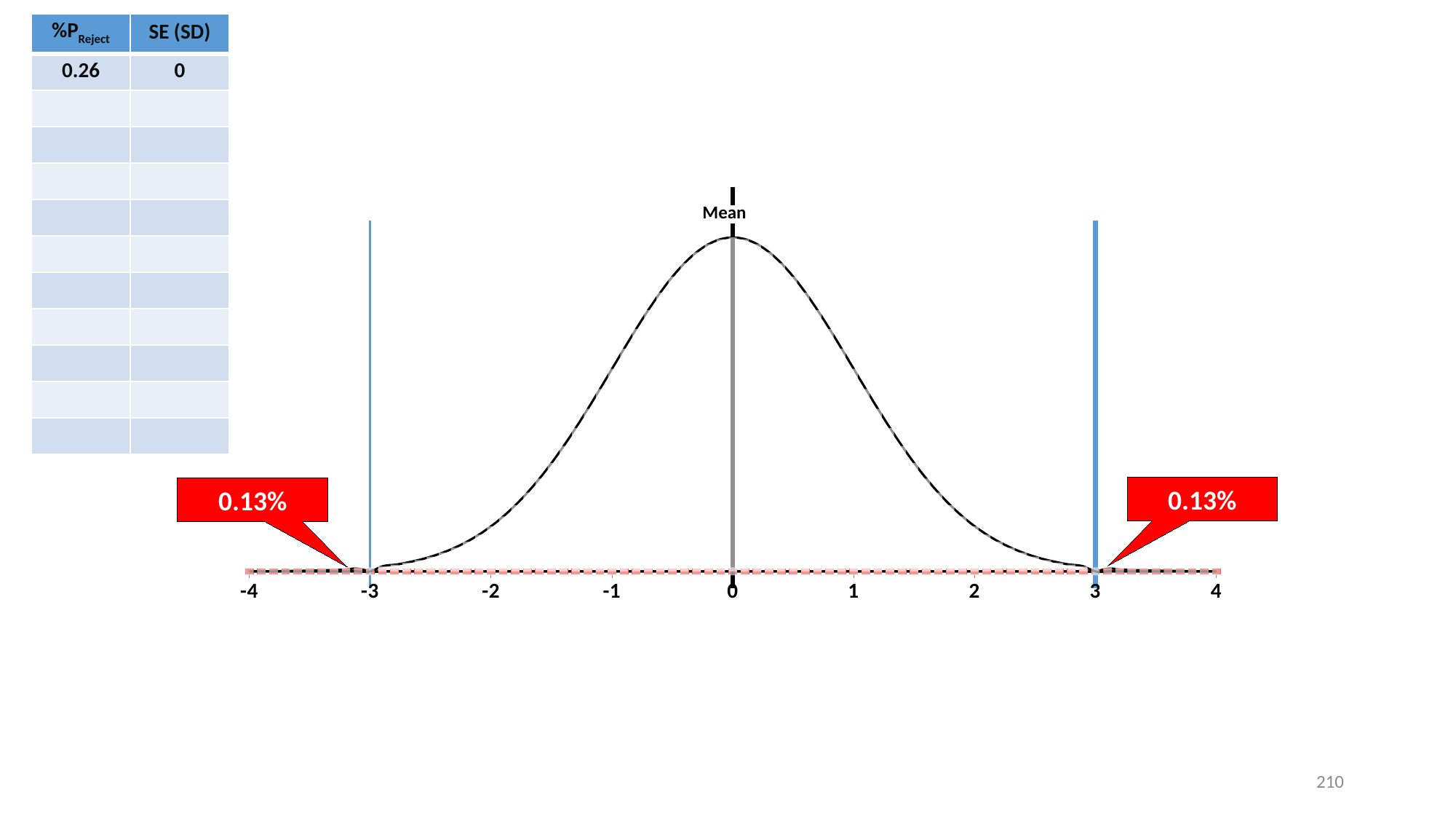
Does the curve rise or fall as x goes from -4 to 0? rise At which two x-axis values are the blue vertical lines drawn? -3 and 3 How many tick labels are shown on the x axis? 9 Does the curve rise or fall as x goes from 0 to 4? fall Which tail callout shows the larger percentage, the left or the right? They are equal What kind of chart is shown on the slide? line chart What is the combined percentage of the two tail callouts? 0.26% At which x-axis value does the curve reach its highest point? 0 What percentage is shown in the callout at the left tail of the curve? 0.13% At which x-axis value is the curve labelled "Mean"? 0 What percentage is shown in the callout at the right tail of the curve? 0.13% What colour are the callout boxes showing the tail percentages? red